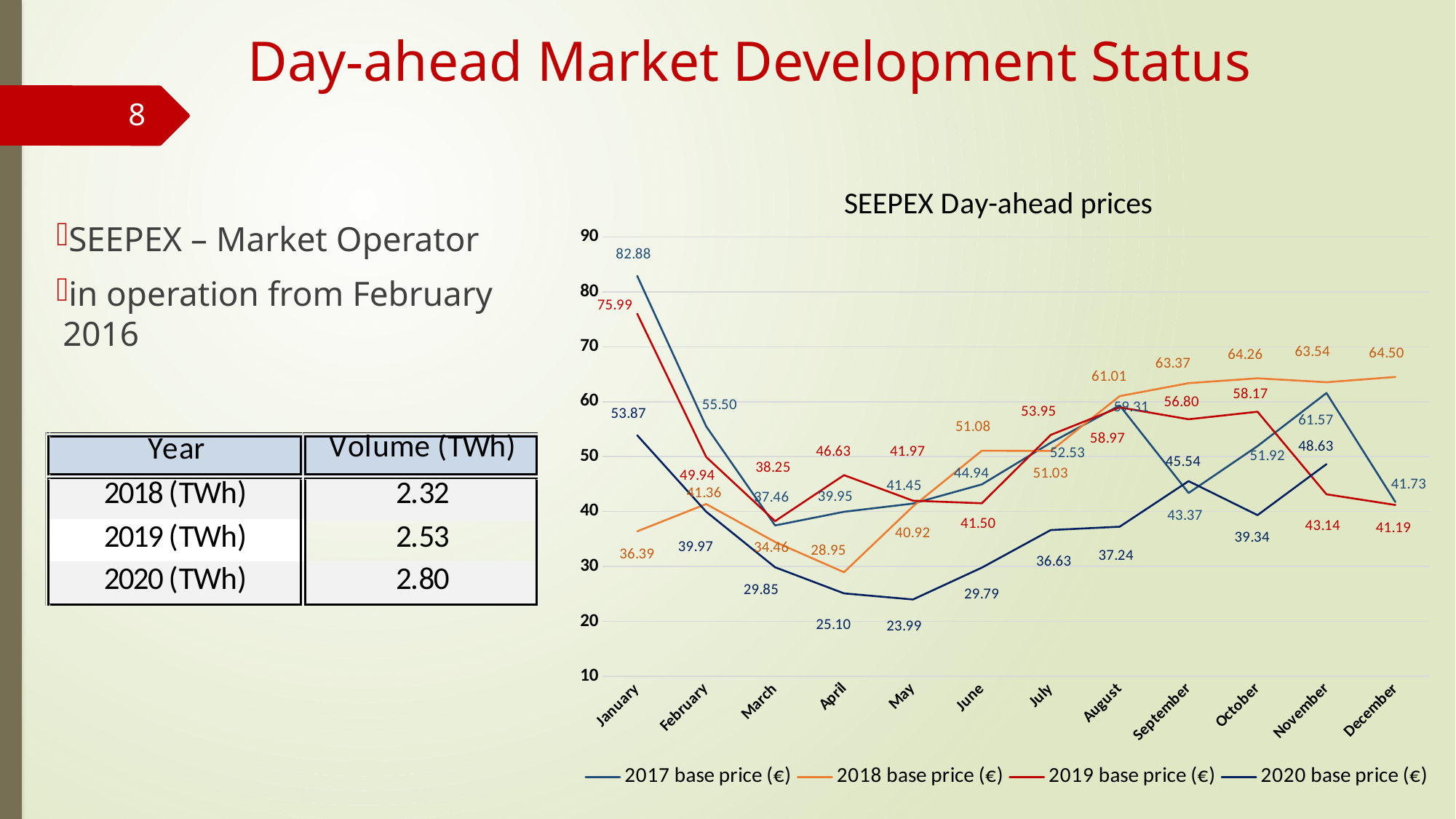
What is the 2017 base price (€) for January? 82.88 In which month is the 2020 base price (€) lowest? May How many months are shown on the x axis of the SEEPEX Day-ahead prices chart? 12 Which is larger in December: the 2018 base price (€) or the 2019 base price (€)? 2018 base price (€) What type of chart is shown on the slide? line chart What is the 2020 base price (€) for May? 23.99 What is the 2018 base price (€) for April? 28.95 What is the difference between the 2017 base price (€) in January and the 2019 base price (€) in January? 6.89 What is the title of the chart on the slide? SEEPEX Day-ahead prices What is the 2019 base price (€) for July? 53.95 How many series does the legend of the SEEPEX Day-ahead prices chart list? 4 In which month is the 2018 base price (€) highest? December